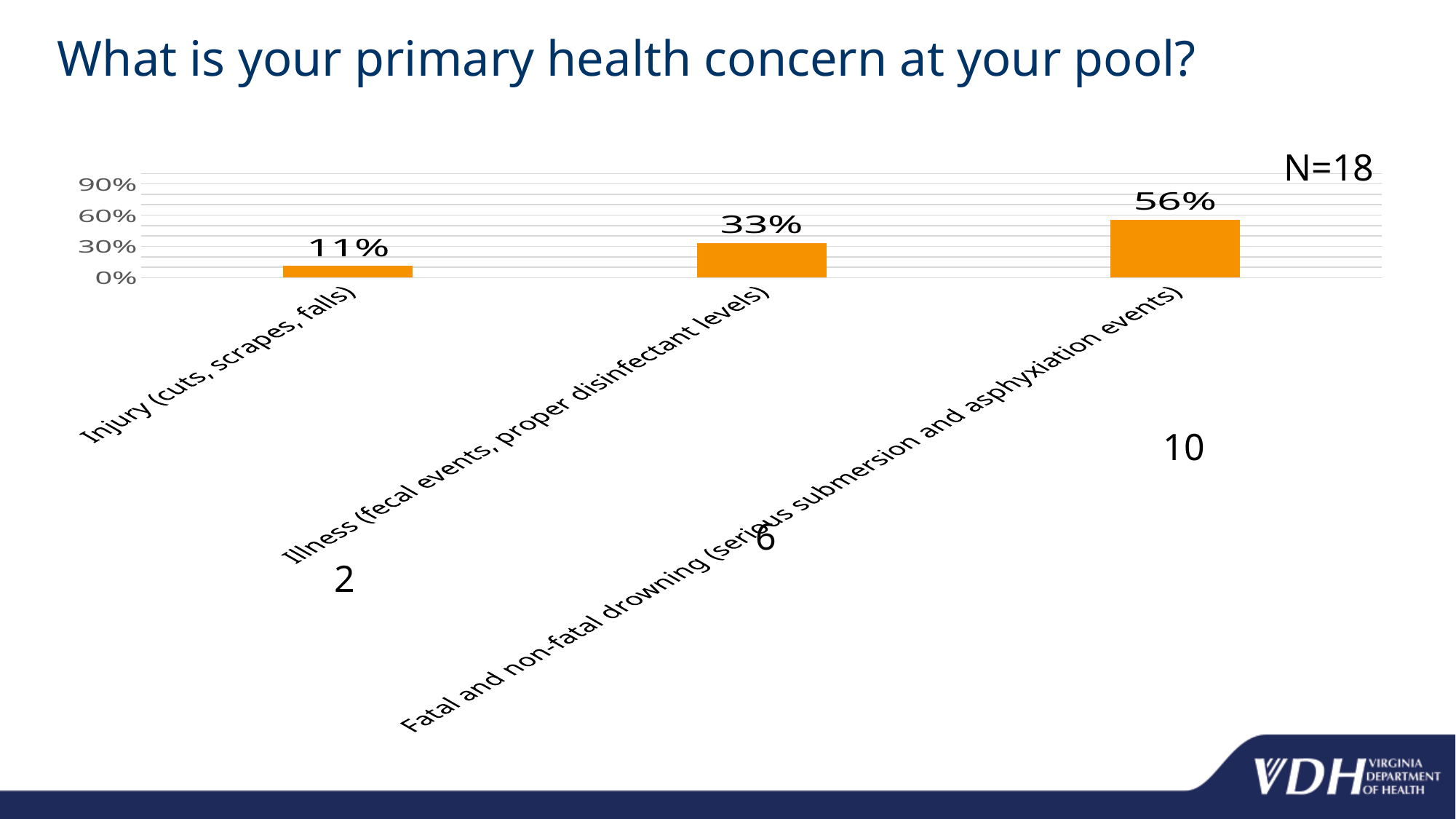
Which is larger, the value for Illness or the value for Injury? Illness What percentage of respondents chose Illness (fecal events, proper disinfectant levels)? 33% Which category has the highest percentage? Fatal and non-fatal drowning (serious submersion and asphyxiation events) Is the value for Fatal and non-fatal drowning greater or less than 30%? greater What percentage of respondents chose Injury (cuts, scrapes, falls) as their primary health concern? 11% What is the total number of respondents (N) shown on the slide? 18 What percentage of respondents chose Fatal and non-fatal drowning (serious submersion and asphyxiation events)? 56% Which category has the lowest percentage? Injury (cuts, scrapes, falls) What is the difference in percentage points between Fatal and non-fatal drowning and Illness? 23 percentage points How many categories are shown in the chart? 3 What kind of chart is shown on the slide? Bar chart What is the difference in percentage points between Illness and Injury? 22 percentage points